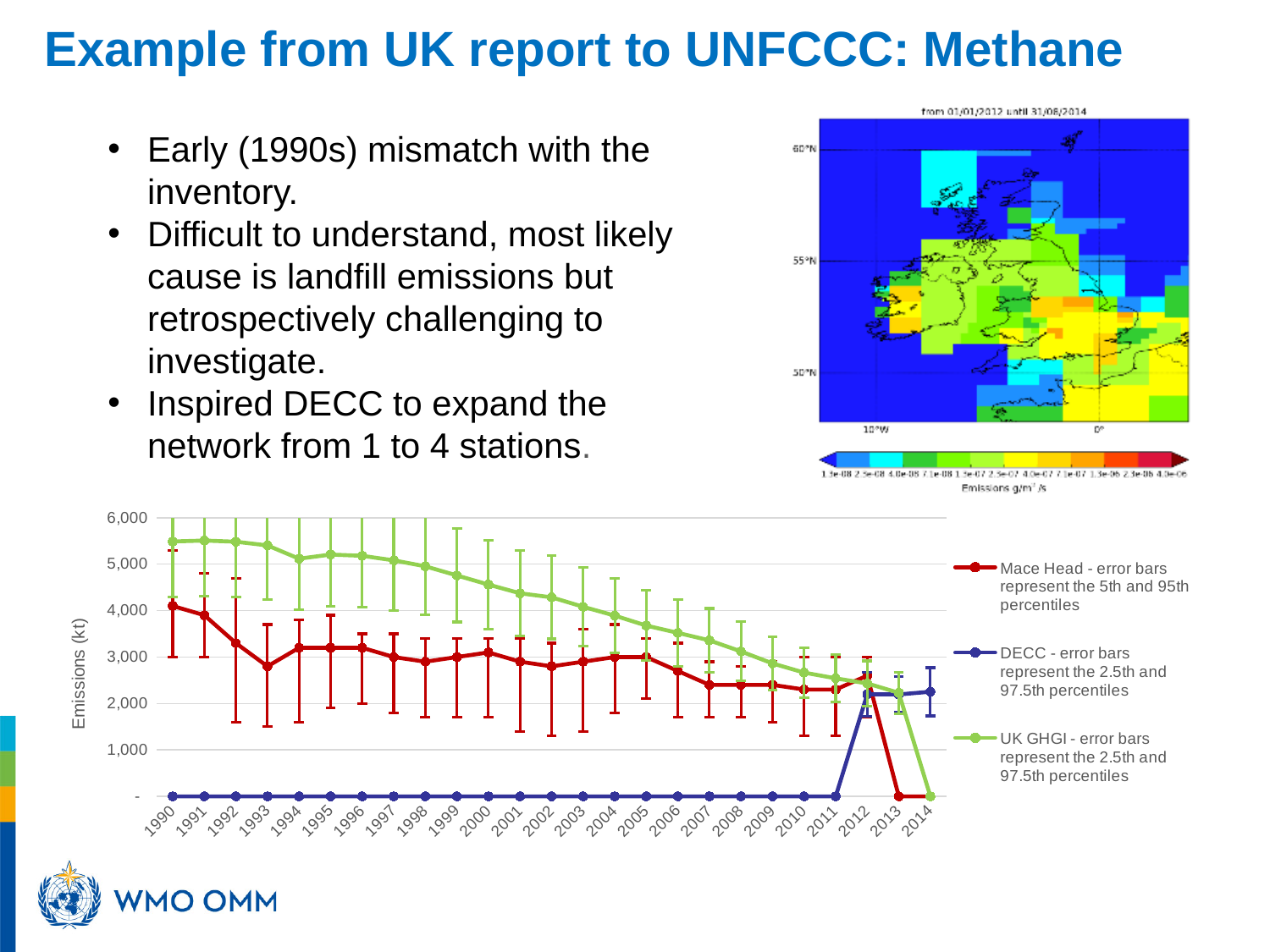
In the emissions line chart, is the UK GHGI value for 2000 greater or less than 4,000? greater In the emissions line chart, is the UK GHGI value for 1990 greater or less than 5,000? greater In the emissions line chart, which series has the higher value in 2005, UK GHGI or Mace Head? UK GHGI What colour is the DECC series line in the emissions line chart? Blue In the emissions line chart, is the Mace Head value for 2010 greater or less than 3,000? less How many years are shown on the x axis of the emissions line chart? 25 What kind of chart is shown at the bottom of the slide? Line chart How many series does the legend of the emissions line chart list? 3 What is the label of the y axis on the emissions line chart? Emissions (kt) In the emissions line chart, which series has the higher value in 1990, UK GHGI or Mace Head? UK GHGI In the emissions line chart, does the UK GHGI series generally rise or fall from 1990 to 2013? fall